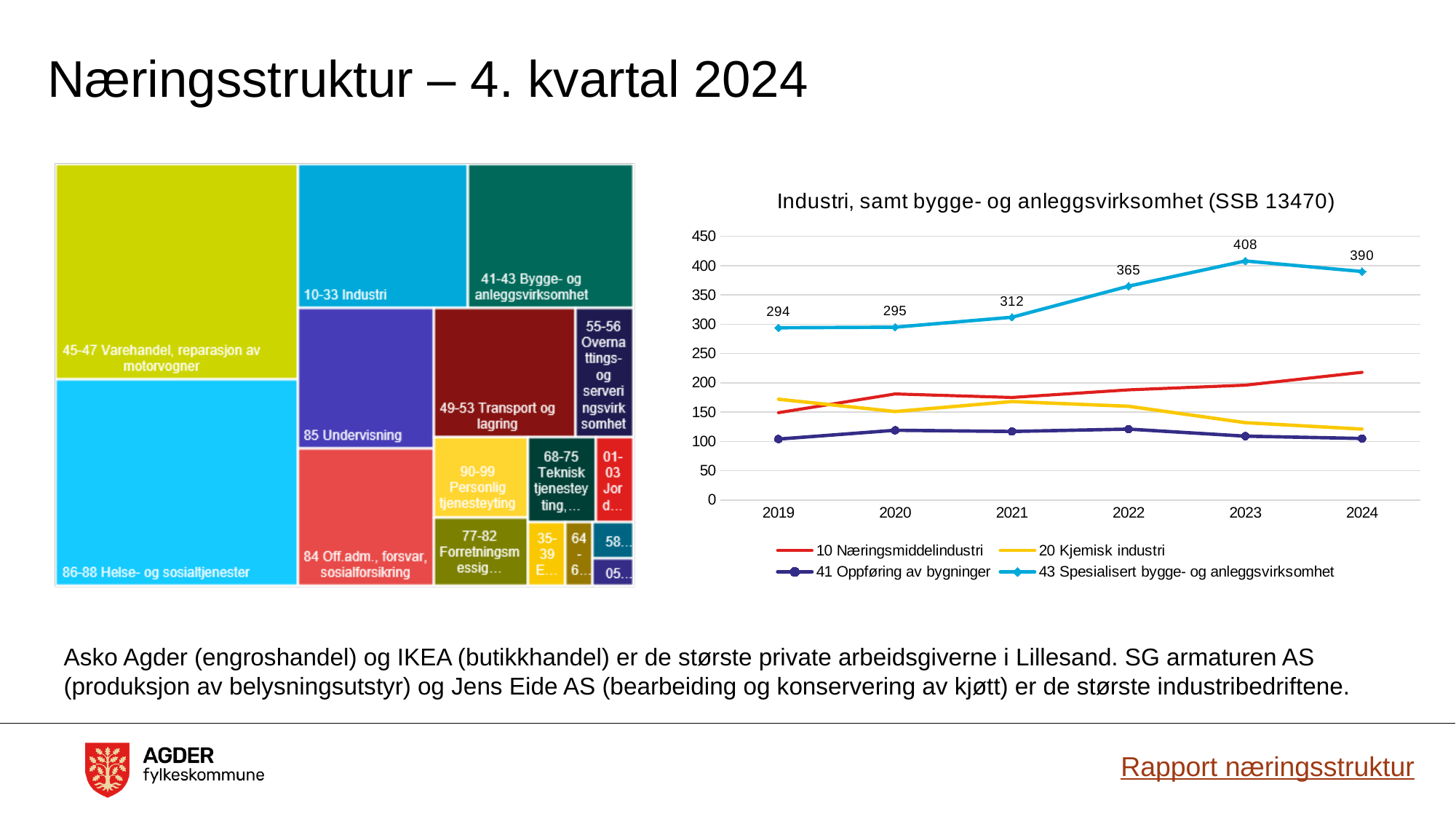
In the line chart on the right, what is the value for 43 Spesialisert bygge- og anleggsvirksomhet in 2024? 390 In the line chart titled 'Industri, samt bygge- og anleggsvirksomhet (SSB 13470)', what is the value for 43 Spesialisert bygge- og anleggsvirksomhet in 2023? 408 In the line chart on the right, what is the difference between the 2023 and 2024 values for 43 Spesialisert bygge- og anleggsvirksomhet? 18 In the line chart on the right, is the value for 10 Næringsmiddelindustri in 2024 greater or less than 200? greater In the line chart on the right, in which year is the value for 43 Spesialisert bygge- og anleggsvirksomhet lowest? 2019 In the line chart on the right, is the value for 41 Oppføring av bygninger in 2019 greater or less than 150? less In the line chart on the right, what is the value for 43 Spesialisert bygge- og anleggsvirksomhet in 2019? 294 In the line chart on the right, what is the difference between the 2022 and 2021 values for 43 Spesialisert bygge- og anleggsvirksomhet? 53 In the line chart on the right, which series has the higher value in 2024: 10 Næringsmiddelindustri or 20 Kjemisk industri? 10 Næringsmiddelindustri How many years are shown on the x axis of the line chart on the right? 6 In the line chart on the right, in which year does 43 Spesialisert bygge- og anleggsvirksomhet reach its highest value? 2023 How many series does the legend of the line chart on the right list? 4